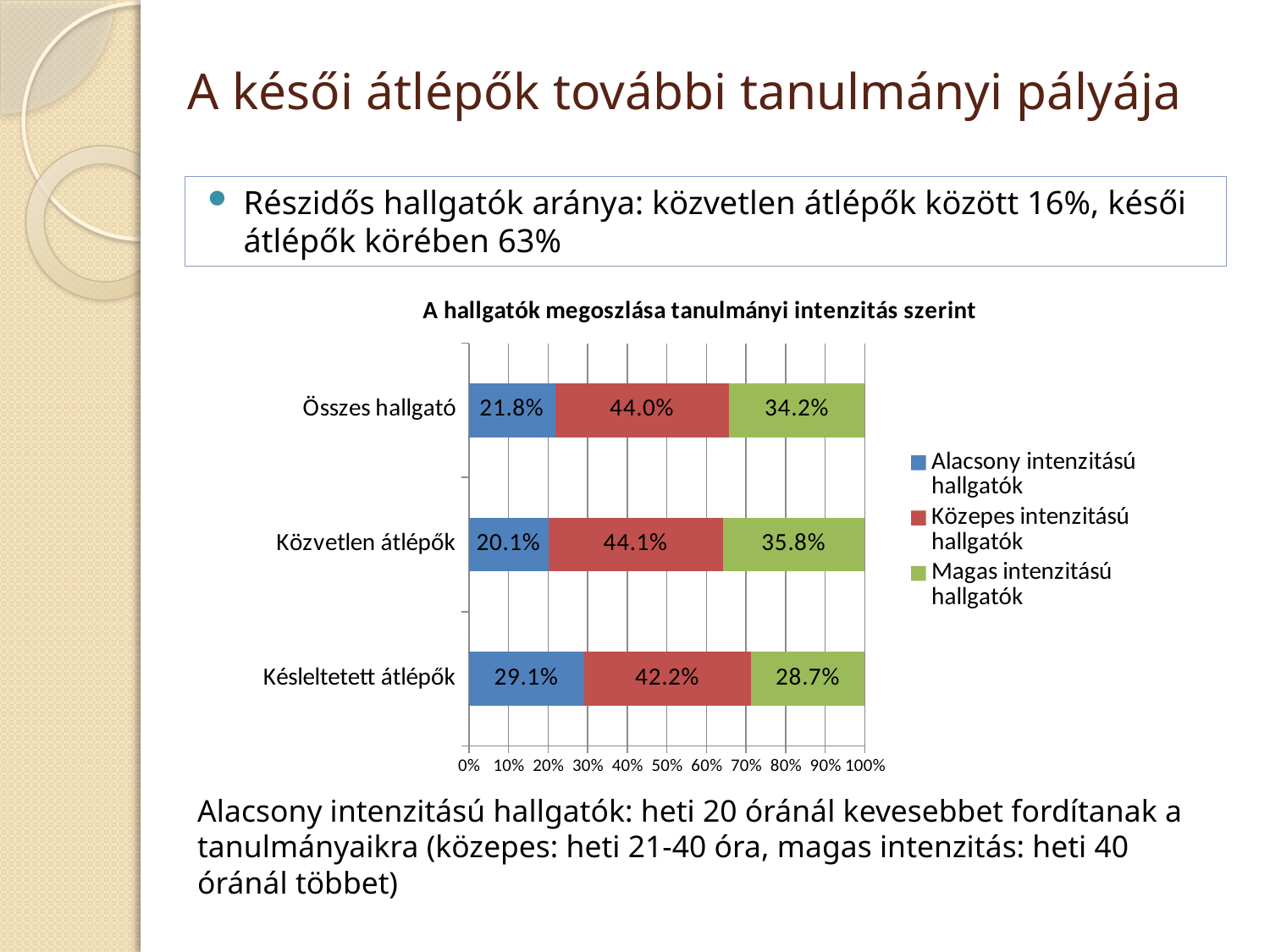
What is the difference in the share of Magas intenzitású hallgatók between Közvetlen átlépők and Késleltetett átlépők? 7.1 percentage points How many categories are shown on the chart's vertical axis? 3 What is the share of Magas intenzitású hallgatók among Közvetlen átlépők? 35.8% Which is larger: the share of Alacsony intenzitású hallgatók among Összes hallgató or among Közvetlen átlépők? Összes hallgató What is the share of Alacsony intenzitású hallgatók among Késleltetett átlépők? 29.1% What type of chart is shown on the slide? Stacked bar chart What is the title of the chart? A hallgatók megoszlása tanulmányi intenzitás szerint Which category has the lowest share of Magas intenzitású hallgatók? Késleltetett átlépők What is the share of Közepes intenzitású hallgatók among Összes hallgató? 44.0% Which colour represents Közepes intenzitású hallgatók in the chart? Red Which category has the highest share of Alacsony intenzitású hallgatók? Késleltetett átlépők How many series does the chart legend list? 3